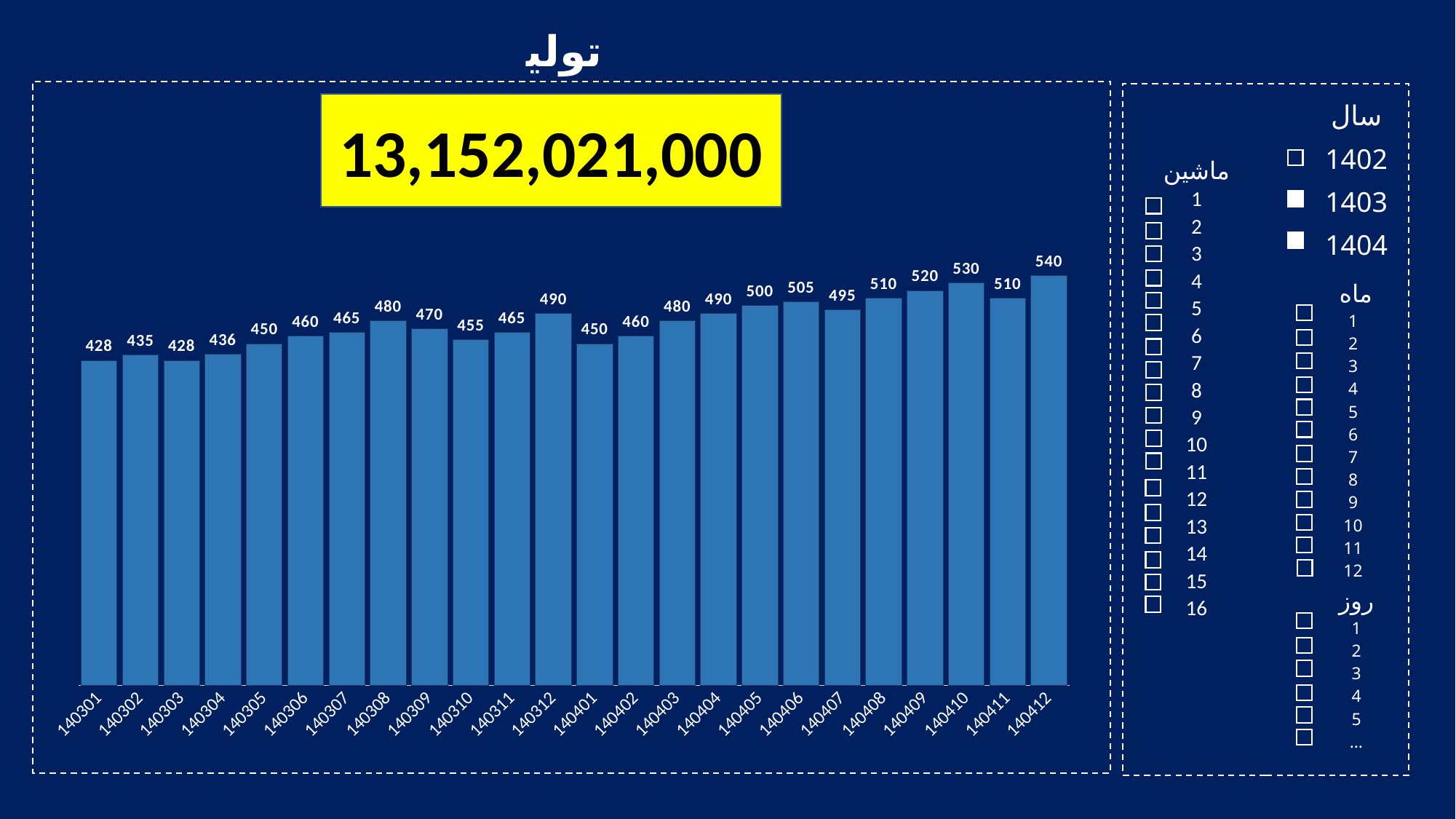
What is the lowest value shown on the chart? 428 What is the large number shown in the yellow box above the chart? 13,152,021,000 How many bars are shown on the chart? 24 Which is larger, the value for 140308 or the value for 140309? 140308 What is the highest value shown on the chart? 540 What is the value for 140312? 490 What kind of chart is shown on the slide? bar chart Which category has the highest value? 140412 What is the value for 140406? 505 What is the value for 140301? 428 What is the difference between the values for 140412 and 140301? 112 What is the difference between the values for 140410 and 140411? 20